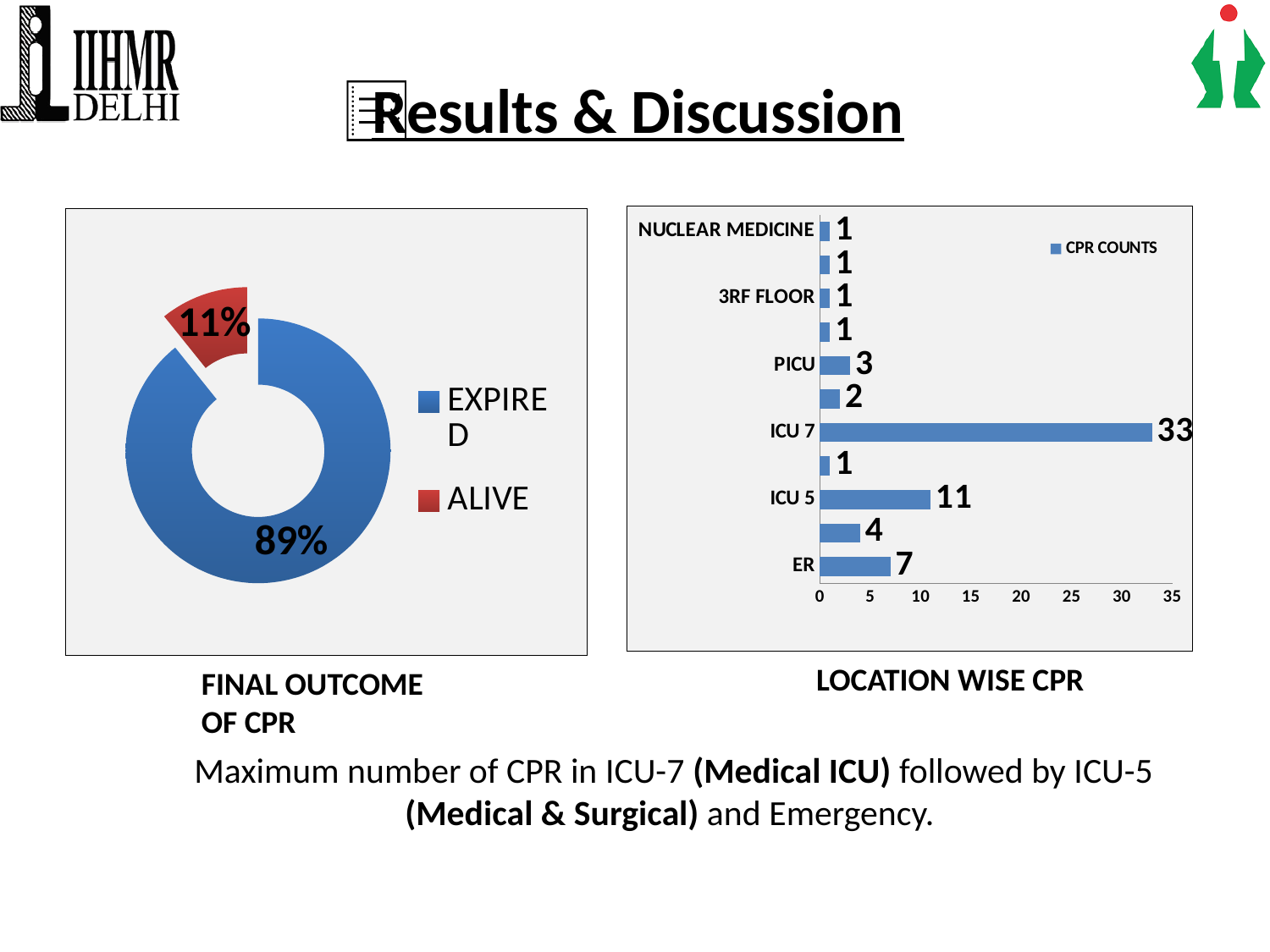
In the LOCATION WISE CPR chart, which location has the highest CPR count? ICU 7 In the FINAL OUTCOME OF CPR chart, what is the difference in percentage points between EXPIRED and ALIVE? 78 In the LOCATION WISE CPR chart, what is the difference between the CPR counts for ICU 7 and ICU 5? 22 In the FINAL OUTCOME OF CPR chart, what percentage of patients were alive? 11% In the FINAL OUTCOME OF CPR chart, which outcome has the larger share? EXPIRED In the FINAL OUTCOME OF CPR chart, what percentage of patients expired? 89% In the LOCATION WISE CPR chart, what is the CPR count for ER? 7 What kind of chart is the LOCATION WISE CPR chart? Bar chart In the LOCATION WISE CPR chart, what is the CPR count for ICU 5? 11 What kind of chart is the FINAL OUTCOME OF CPR chart? Doughnut chart In the LOCATION WISE CPR chart, what is the CPR count for ICU 7? 33 In the LOCATION WISE CPR chart, what is the CPR count for PICU? 3